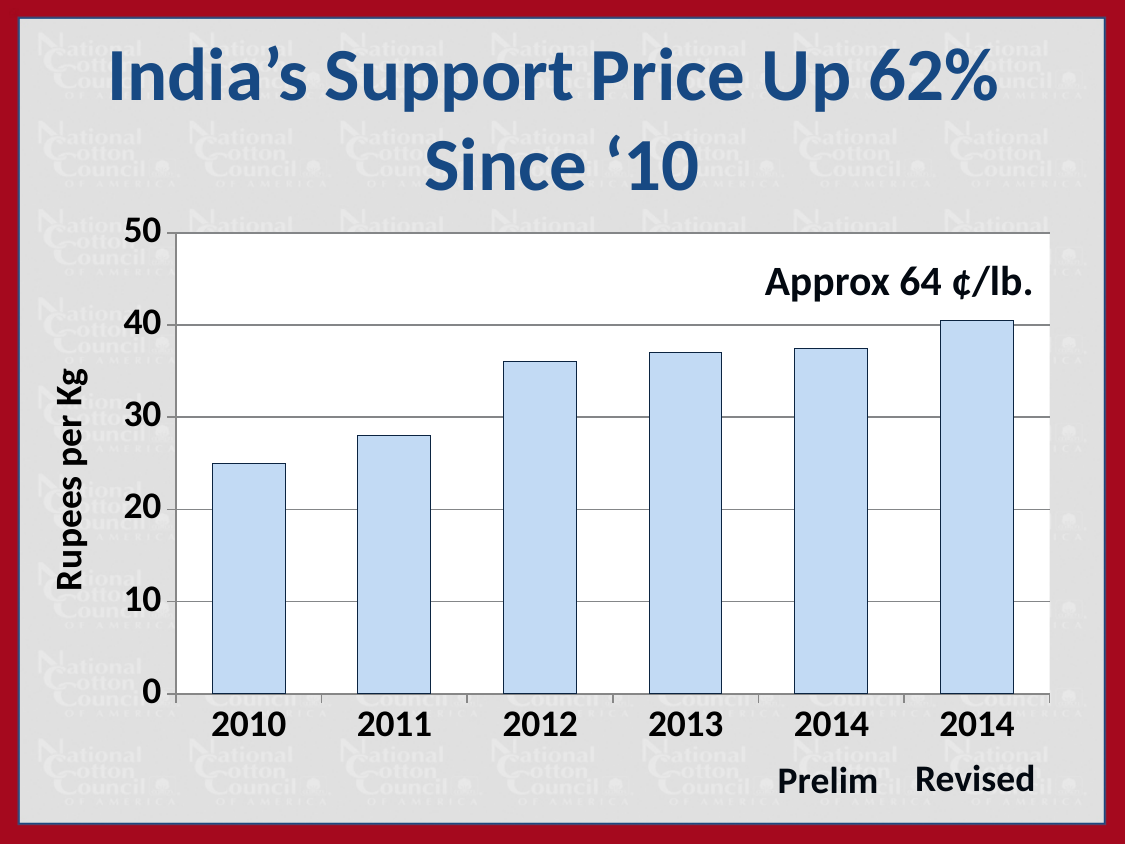
Is the value for 2010 greater or less than 30? less Is the value for 2010 greater or less than 20? greater Is the value for 2014 Prelim greater or less than 40? less What is the title of the chart? India's Support Price Up 62% Since '10 Which category has the highest support price? 2014 Revised Which is larger, the value for 2012 or the value for 2010? 2012 How many bars are plotted in the chart? 6 What is the label on the vertical axis? Rupees per Kg What kind of chart is shown on the slide? bar chart Do the values generally rise or fall from 2010 to 2014 Revised? rise Which year has the lowest support price? 2010